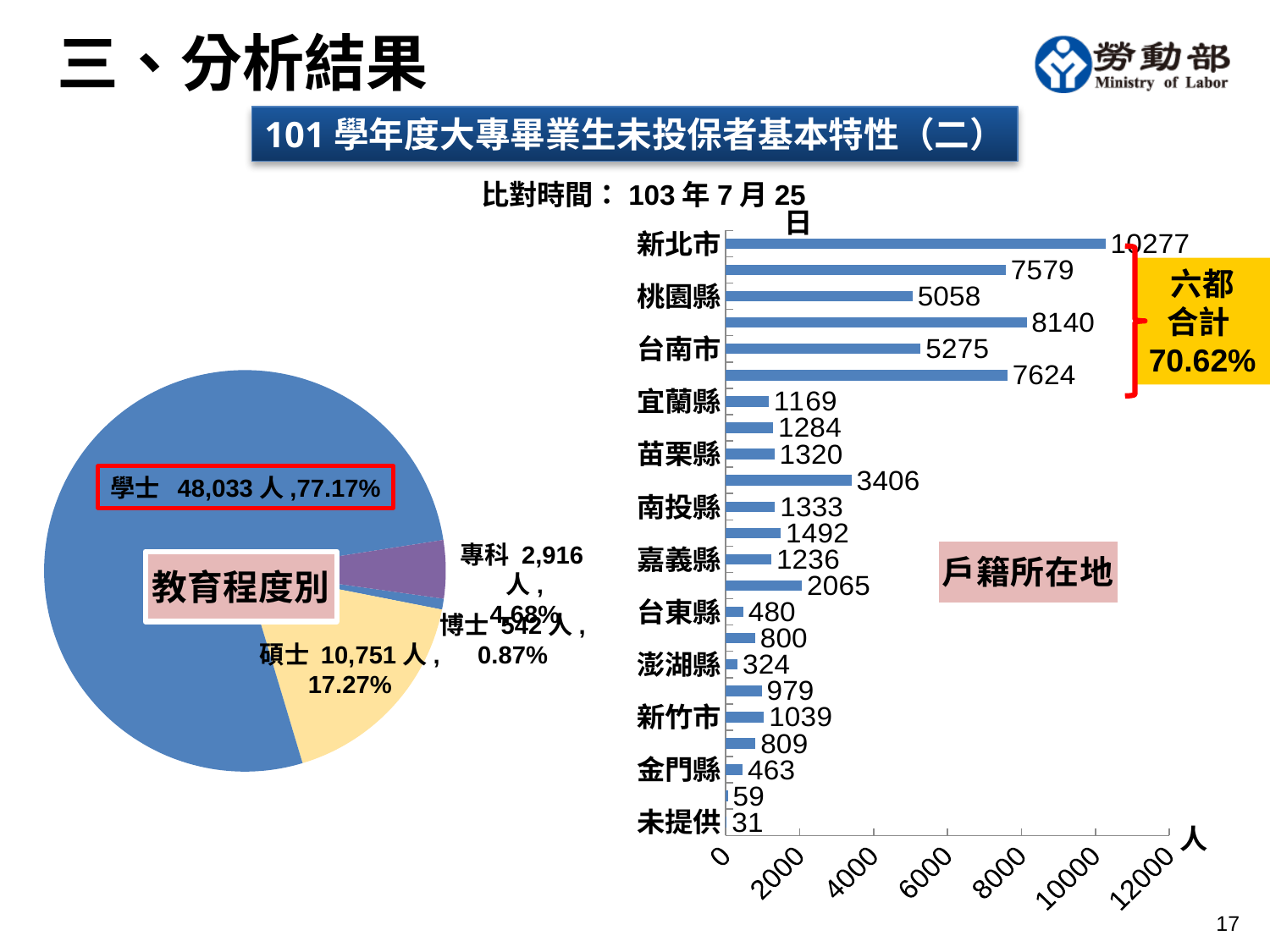
In the 教育程度別 pie chart, how many people are in the 學士 category? 48,033 人 In the 教育程度別 pie chart, what share does 碩士 have? 17.27% In the 戶籍所在地 bar chart, what is the value for 台南市? 5275 In the 戶籍所在地 bar chart, what is the difference between the values for 新北市 and 桃園縣? 5219 In the 戶籍所在地 bar chart, which category has the lowest value? 未提供 In the 戶籍所在地 bar chart, what is the value for 澎湖縣? 324 In the 教育程度別 pie chart, which category has the smallest slice? 博士 In the 戶籍所在地 bar chart, what is the value for 新北市? 10277 In the 戶籍所在地 bar chart, which labelled category has the highest value? 新北市 How many slices does the 教育程度別 pie chart have? 4 In the 戶籍所在地 bar chart, which is larger, the value for 桃園縣 or 台南市? 台南市 What kind of chart is the 戶籍所在地 chart on the right? bar chart